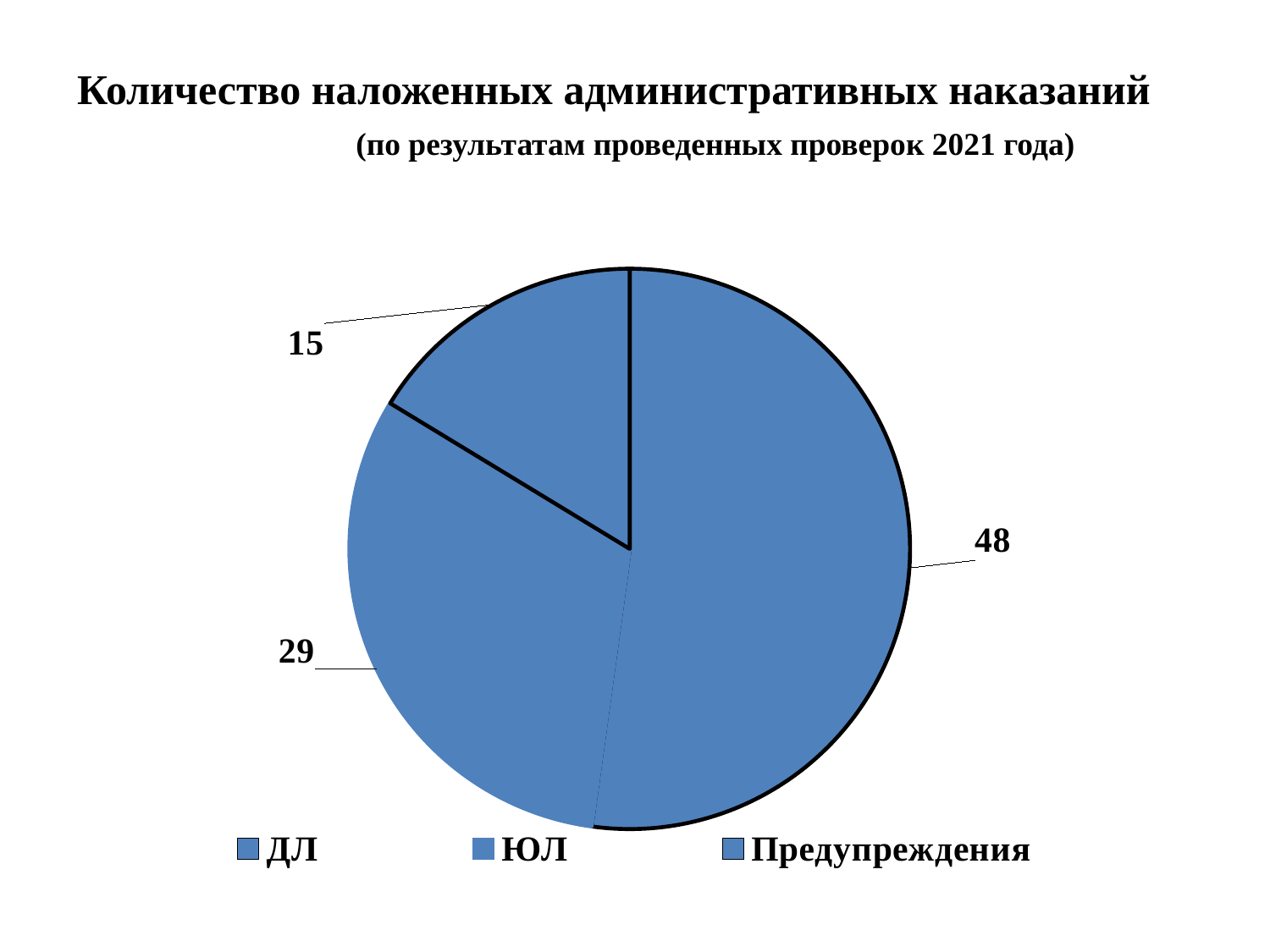
What is the value for ЮЛ? 29 What is the difference between the largest slice (48) and the smallest slice (15)? 33 What is the value for Предупреждения? 15 What is the value for ДЛ? 48 What kind of chart is shown on the slide? pie chart How many entries does the legend list? 3 How many slices does the pie chart have? 3 What is the value of the smallest slice of the pie chart? 15 What is the title of the chart on the slide? Количество наложенных административных наказаний (по результатам проведенных проверок 2021 года) What is the total of all three slices in the pie chart? 92 What is the value of the largest slice of the pie chart? 48 Which is larger, the slice for ЮЛ or the slice for Предупреждения? ЮЛ